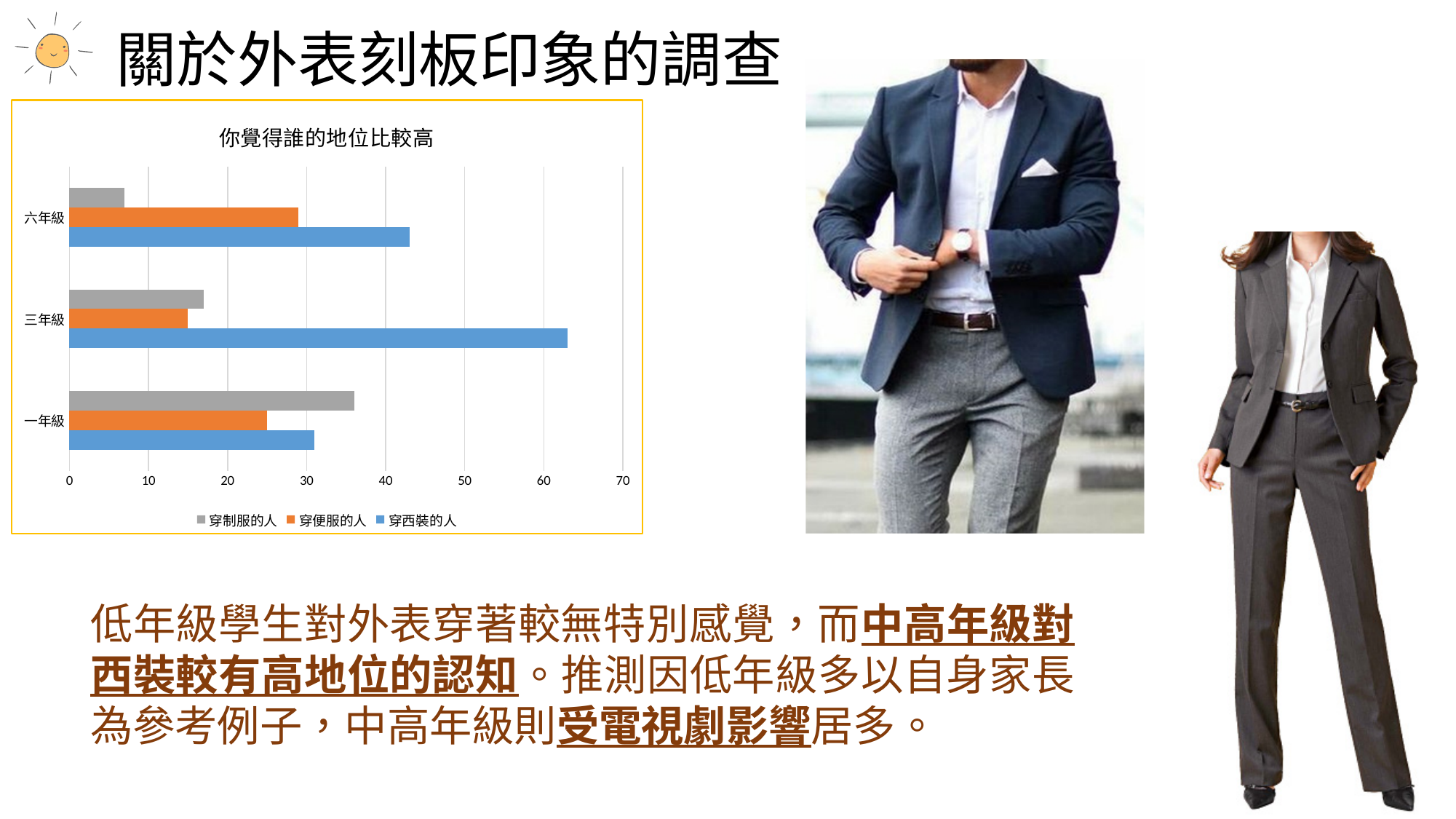
For which grade is the value for 穿西裝的人 the highest? 三年級 Which series is shown in blue in the chart's legend? 穿西裝的人 How many grade categories are shown on the chart's vertical axis? 3 How many series does the chart's legend list? 3 Is the value for 穿西裝的人 in 三年級 greater or less than 60? greater Is the value for 穿制服的人 in 六年級 greater or less than 10? less In 六年級, which is larger: the value for 穿西裝的人 or the value for 穿便服的人? 穿西裝的人 Is the value for 穿西裝的人 in 六年級 greater or less than 40? greater What is the title of the chart? 你覺得誰的地位比較高 What kind of chart is shown on the slide? bar chart For which grade is the value for 穿制服的人 the lowest? 六年級 In 一年級, which is larger: the value for 穿制服的人 or the value for 穿便服的人? 穿制服的人